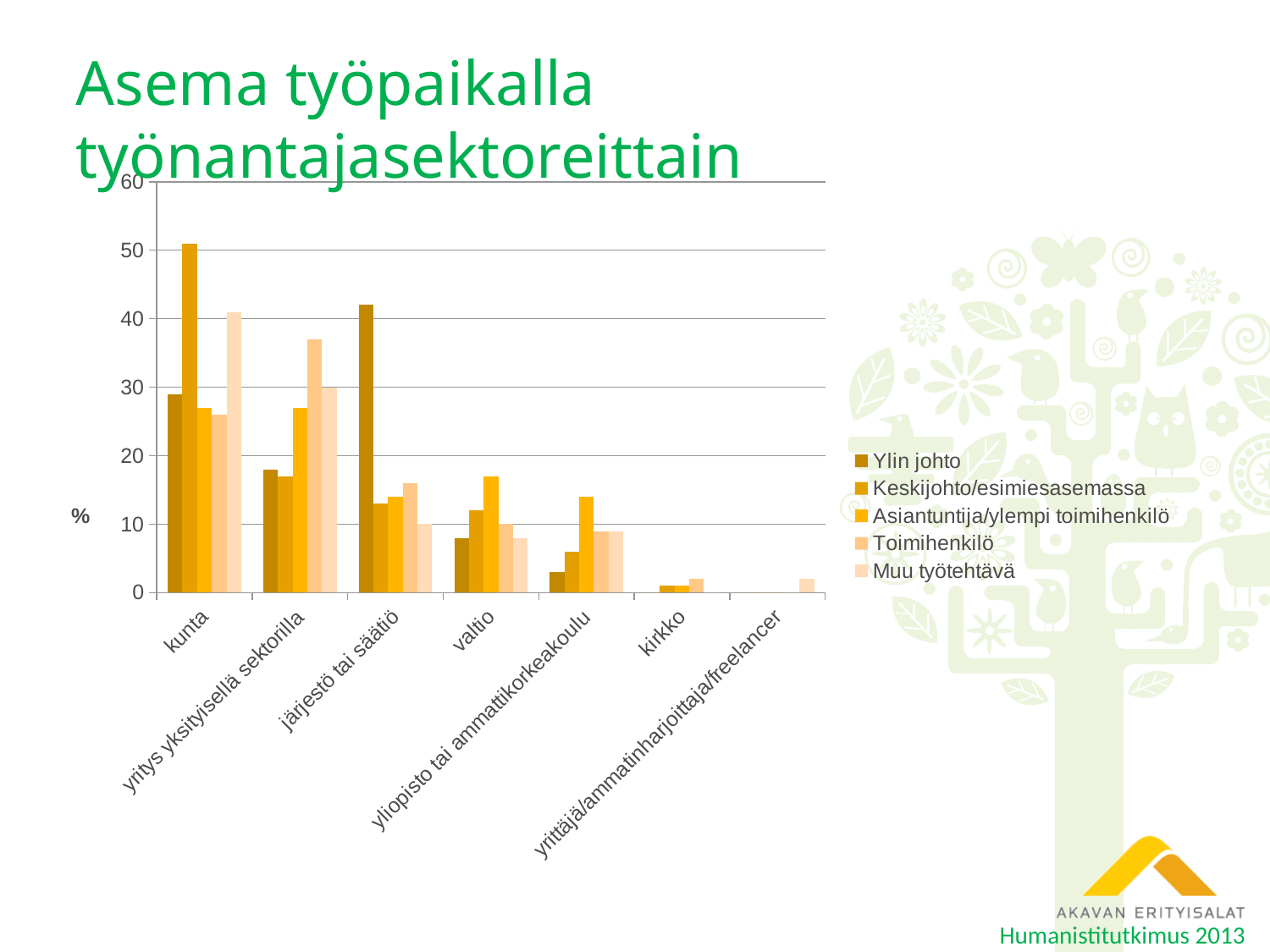
What kind of chart is shown on the slide? bar chart Which series has the highest value in the kunta category? Keskijohto/esimiesasemassa Is the value for Ylin johto in järjestö tai säätiö greater or less than 40? greater What is the label on the y axis? % Is the value for Muu työtehtävä in kunta greater or less than 30? greater How many series does the legend list? 5 Which category has the highest Keskijohto/esimiesasemassa value? kunta Which is larger, the Ylin johto value for kunta or for yritys yksityisellä sektorilla? kunta Which series has the highest value in the järjestö tai säätiö category? Ylin johto Is the value for Toimihenkilö in yritys yksityisellä sektorilla greater or less than 30? greater How many employer sector categories are shown on the x axis? 7